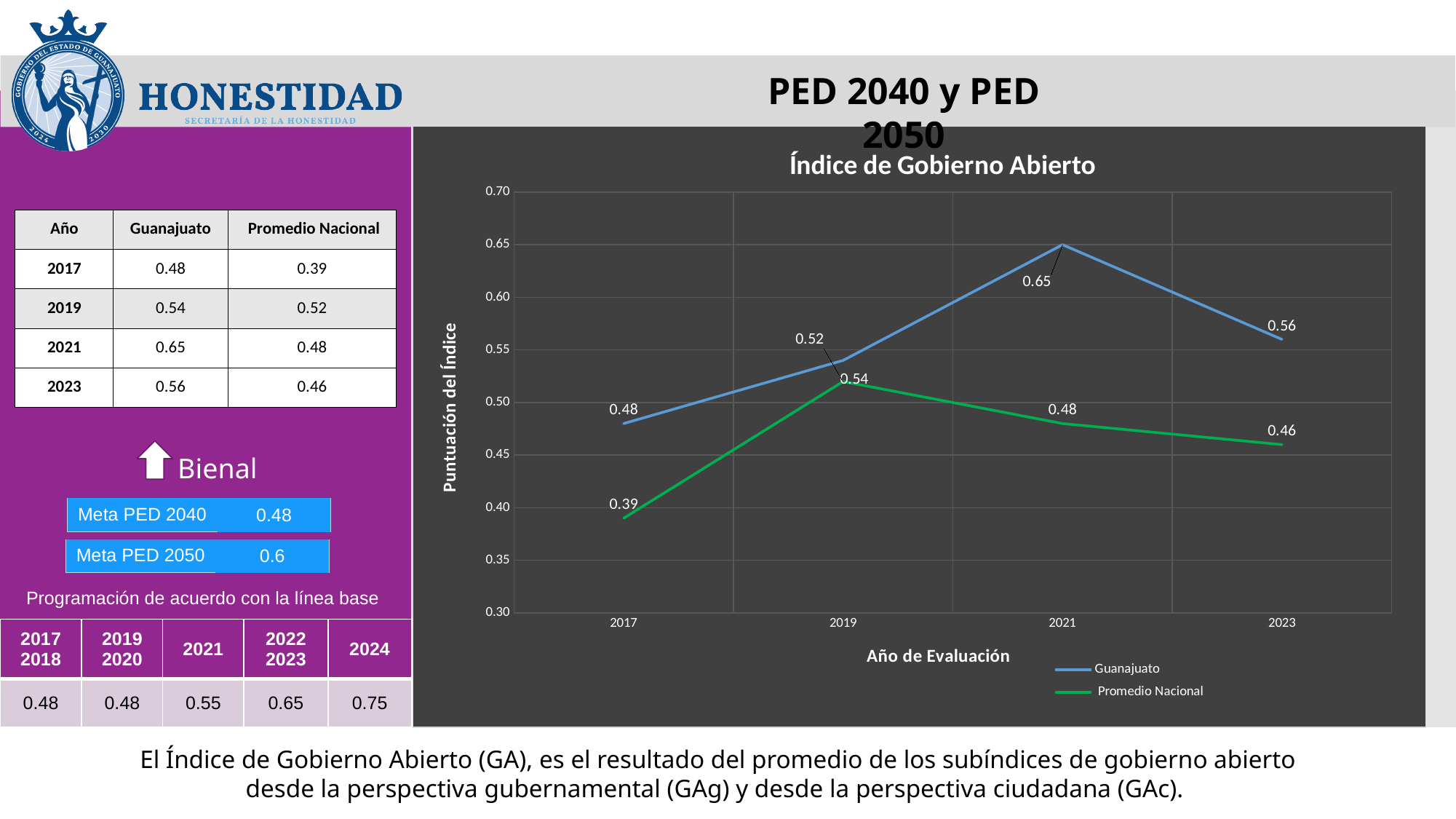
What is the Promedio Nacional value for 2017 in the chart? 0.39 How many series does the chart legend list? 2 How many evaluation years are plotted on the x axis of the chart? 4 What is the title of the chart? Índice de Gobierno Abierto Which series has the higher value in 2023, Guanajuato or Promedio Nacional? Guanajuato Does the Promedio Nacional series rise or fall from 2019 to 2023? fall In which year does the Guanajuato series reach its highest value? 2021 What is the difference between the Guanajuato and Promedio Nacional values in 2021? 0.17 What type of chart is shown on the slide? line chart In which year is the Promedio Nacional series at its lowest value? 2017 What is the Guanajuato value for 2021 in the chart? 0.65 What is the Guanajuato value for 2023 in the chart? 0.56